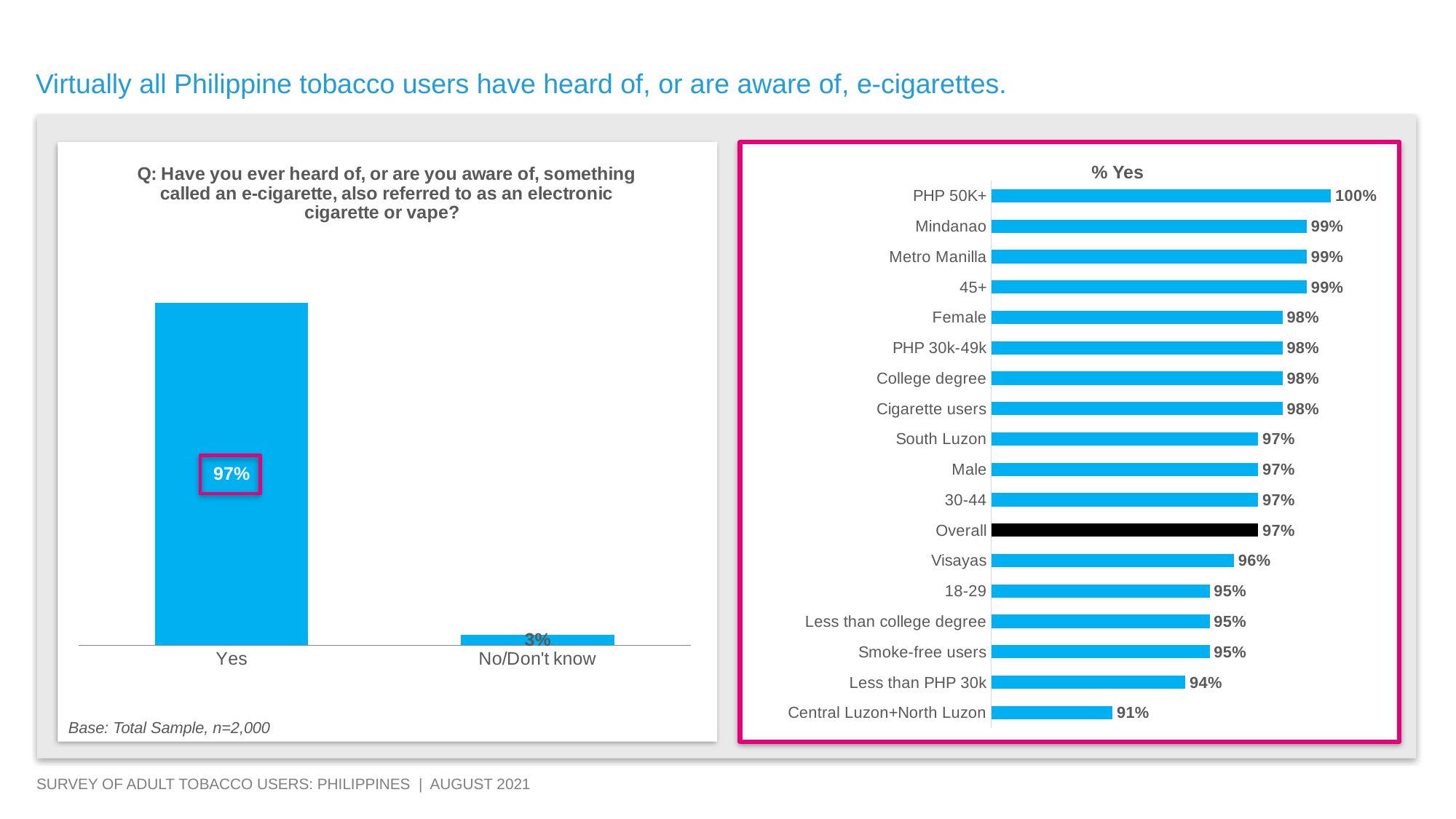
In the right chart titled '% Yes', how many categories are listed? 18 In the left chart, what percentage answered No/Don't know? 3% In the right chart titled '% Yes', which is larger, the value for Visayas or the value for Mindanao? Mindanao In the right chart titled '% Yes', which category's bar is coloured black instead of blue? Overall In the right chart titled '% Yes', what is the value for Central Luzon+North Luzon? 91% In the right chart titled '% Yes', what is the difference between the values for PHP 50K+ and Less than PHP 30k? 6% What kind of chart is the left chart? Bar chart In the right chart titled '% Yes', what is the value for PHP 50K+? 100% In the left chart, how many categories are shown on the x axis? 2 In the right chart titled '% Yes', which category has the lowest value? Central Luzon+North Luzon In the right chart titled '% Yes', which category has the highest value? PHP 50K+ In the left chart, what percentage of respondents answered Yes? 97%